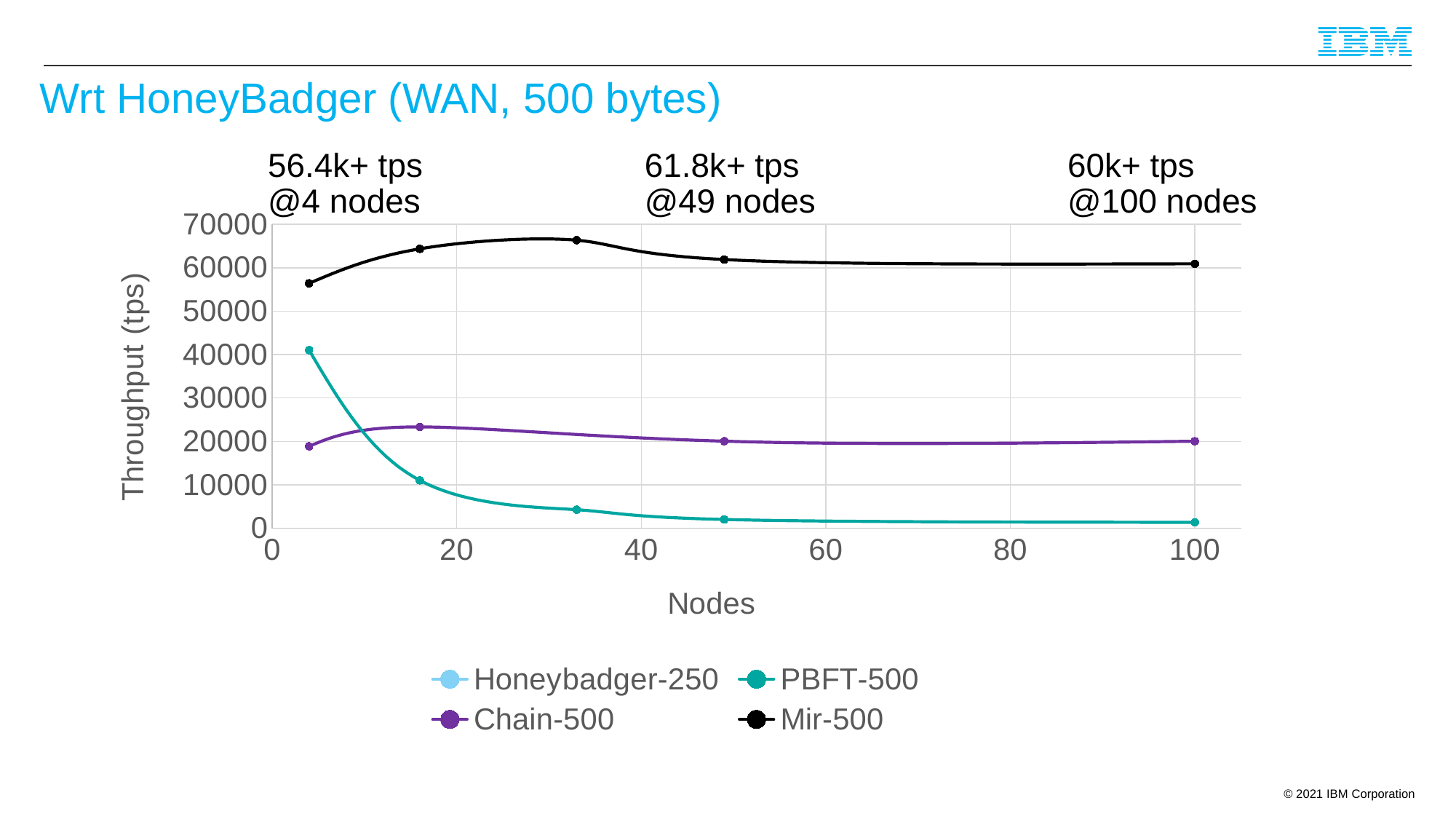
What kind of chart is shown on the slide? line chart Does the throughput of PBFT-500 rise or fall as the number of nodes increases? fall Which series has the lowest throughput at 100 nodes? PBFT-500 What is the label of the y axis? Throughput (tps) At 4 nodes, which has the higher throughput, PBFT-500 or Chain-500? PBFT-500 How many series does the legend list? 4 Is the throughput of Chain-500 at 100 nodes greater or less than 30000? less What throughput annotation is shown for Mir-500 at 49 nodes? 61.8k+ tps Is the throughput of PBFT-500 at 49 nodes greater or less than 10000? less What is the title of the slide's chart? Wrt HoneyBadger (WAN, 500 bytes) Is the throughput of Mir-500 at 4 nodes greater or less than 50000? greater Which series has the highest throughput across all node counts? Mir-500